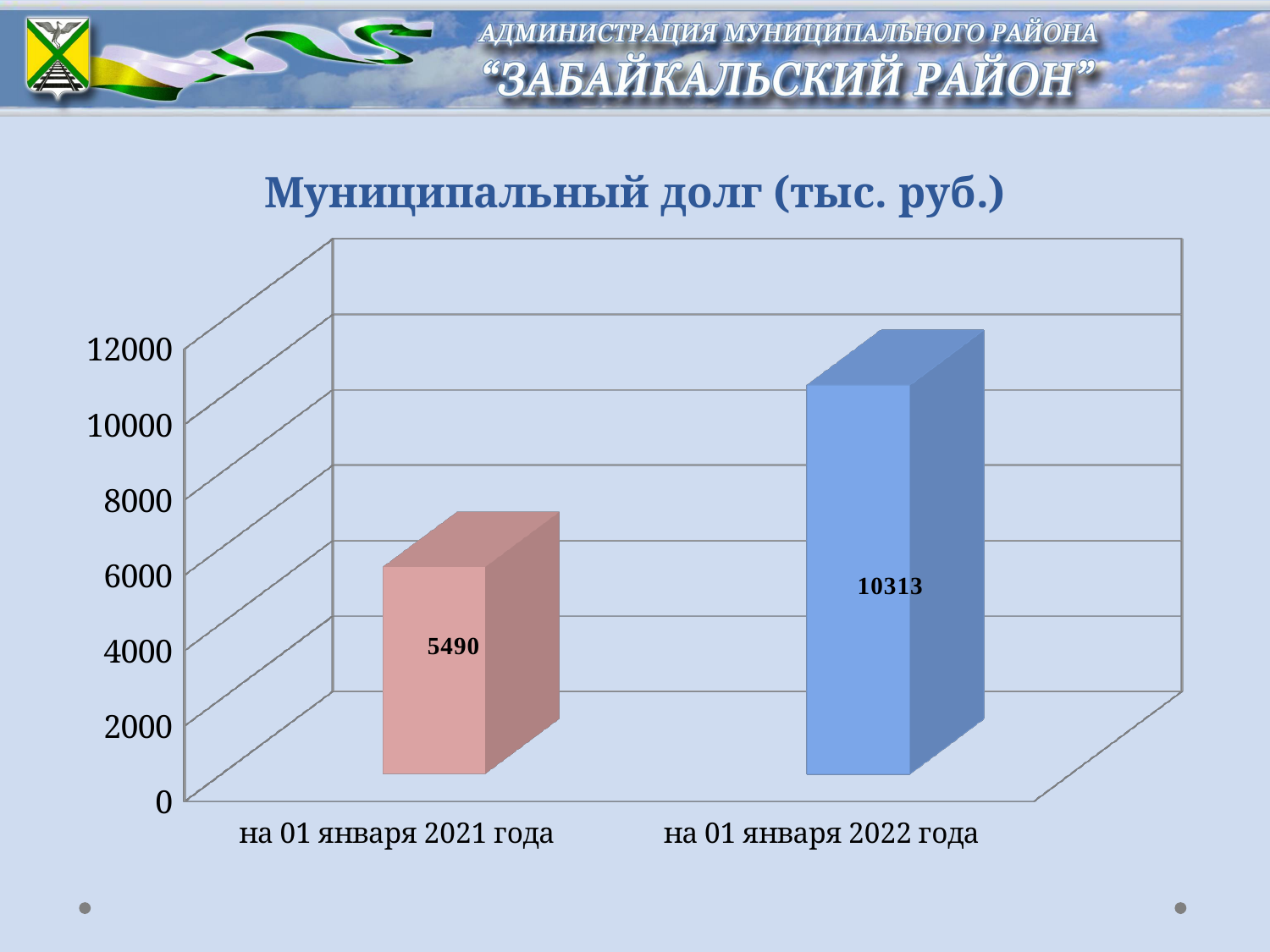
What is the municipal debt value shown for 'на 01 января 2022 года'? 10313 What is the title of the chart? Муниципальный долг (тыс. руб.) Which is larger: the value for 'на 01 января 2021 года' or for 'на 01 января 2022 года'? на 01 января 2022 года What kind of chart is shown on the slide? bar chart Which category has the highest value in the chart? на 01 января 2022 года Do the values rise or fall from 'на 01 января 2021 года' to 'на 01 января 2022 года'? rise What is the difference between the values for 'на 01 января 2022 года' and 'на 01 января 2021 года'? 4823 Which category has the lowest value in the chart? на 01 января 2021 года Is the value for 'на 01 января 2022 года' greater or less than 10000? greater What is the municipal debt value shown for 'на 01 января 2021 года'? 5490 Is the value for 'на 01 января 2021 года' greater or less than 6000? less How many categories are shown on the x axis of the chart? 2